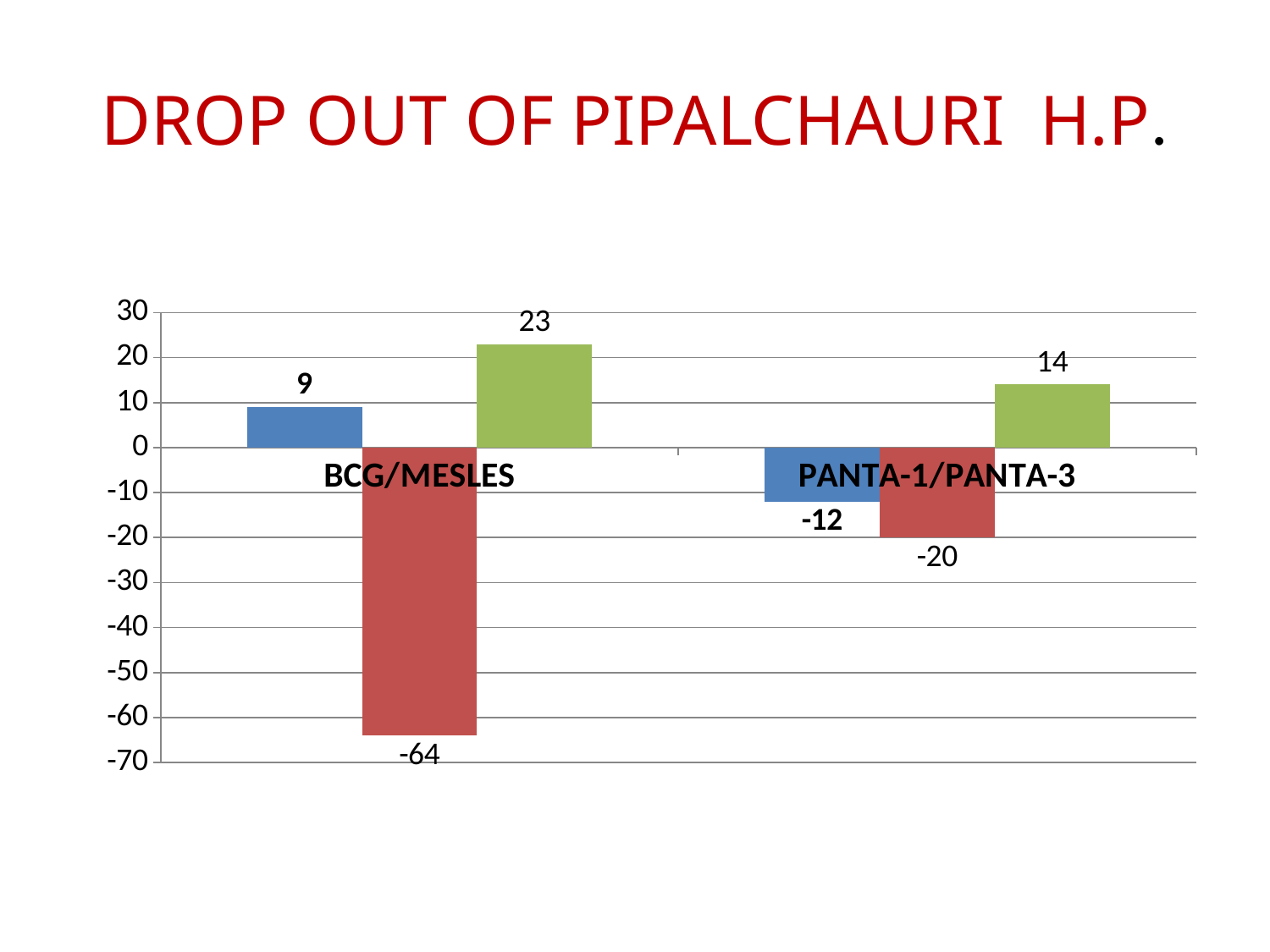
What is the value of the blue bar for BCG/MESLES? 9 What is the value of the red bar for PANTA-1/PANTA-3? -20 How many categories are shown on the x axis of the chart? 2 What is the value of the green bar for PANTA-1/PANTA-3? 14 What type of chart is shown on the slide? bar chart What is the value of the blue bar for PANTA-1/PANTA-3? -12 What is the value of the red bar for BCG/MESLES? -64 What is the difference between the green bar values for BCG/MESLES and PANTA-1/PANTA-3? 9 What is the title of the slide containing the chart? DROP OUT OF PIPALCHAURI H.P. Which bar in the chart has the lowest value? the red bar for BCG/MESLES (-64) What is the value of the green bar for BCG/MESLES? 23 Which bar in the chart has the highest value? the green bar for BCG/MESLES (23)